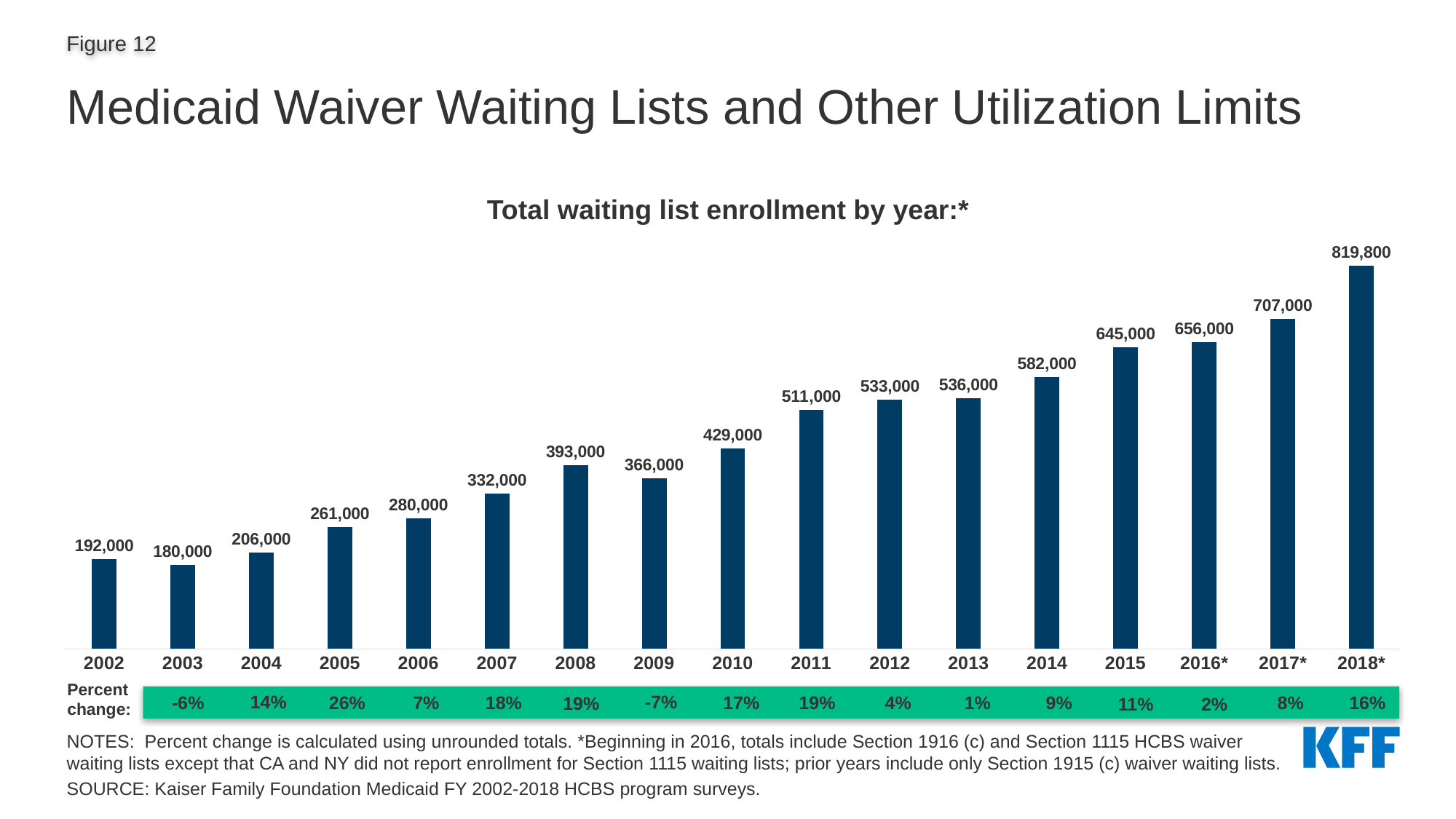
What is the percent change shown for 2005? 26% How many years are shown on the x axis of the chart? 17 What is the difference in waiting list enrollment between 2017* and 2016*? 51,000 What is the title of the chart on the slide? Total waiting list enrollment by year:* Do the waiting list enrollment values generally rise or fall from 2002 to 2018*? rise Which year has the highest total waiting list enrollment? 2018* What was the total waiting list enrollment in 2018*? 819,800 Which year has the lowest total waiting list enrollment? 2003 What was the total waiting list enrollment in 2010? 429,000 What is the percent change shown for 2009? -7% Which year had higher waiting list enrollment, 2008 or 2009? 2008 What kind of chart is used to show total waiting list enrollment by year? bar chart